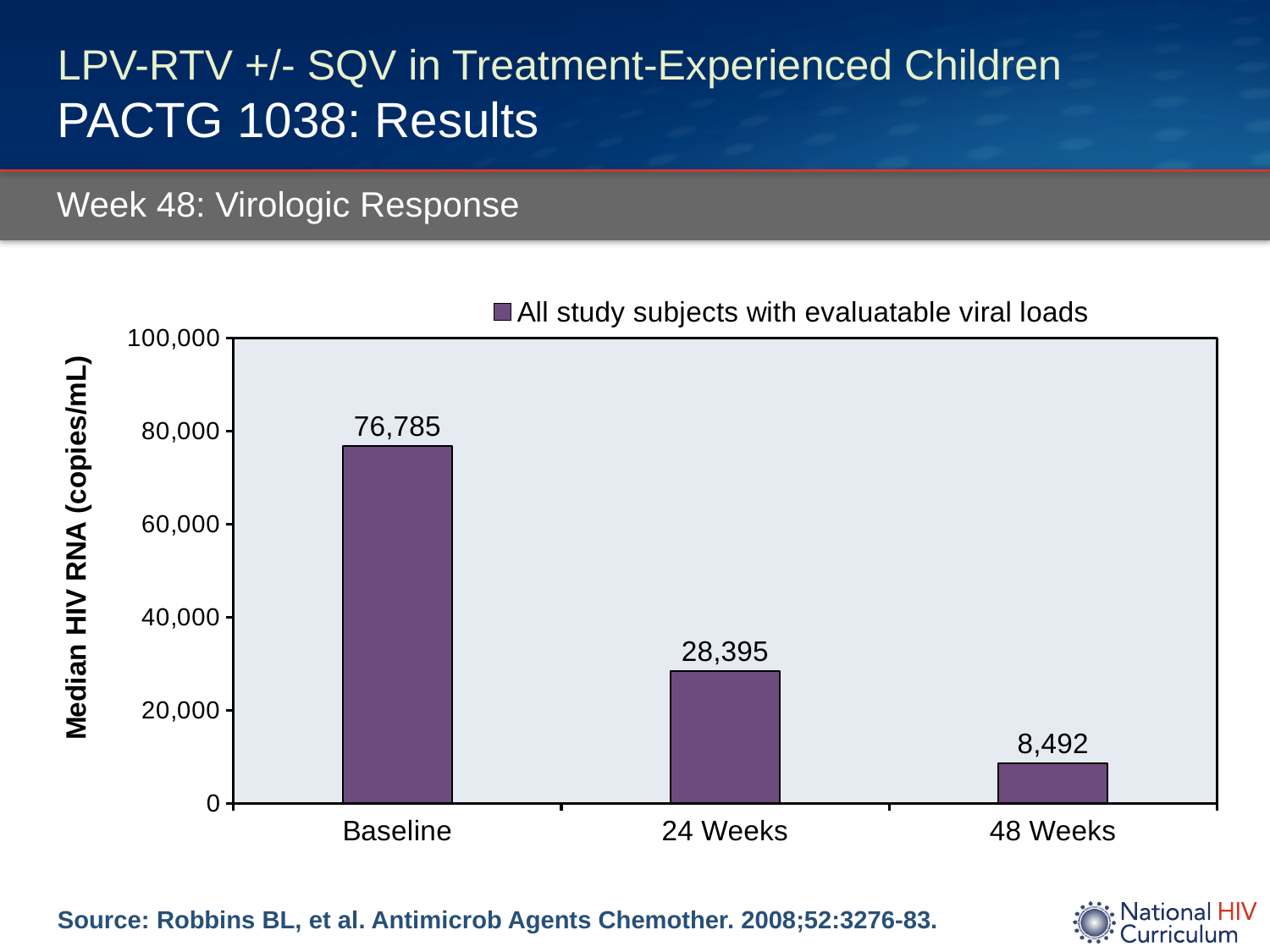
Which time point has the highest median HIV RNA? Baseline Which time point has the lowest median HIV RNA? 48 Weeks What is the median HIV RNA at Baseline? 76,785 How many time points are shown on the x axis? 3 What kind of chart is shown on the slide? Bar chart Do the median HIV RNA values rise or fall from Baseline to 48 Weeks? Fall What is the median HIV RNA at 48 Weeks? 8,492 Which is larger, the median HIV RNA at 24 Weeks or at 48 Weeks? 24 Weeks What is the difference in median HIV RNA between Baseline and 24 Weeks? 48,390 Is the median HIV RNA at 24 Weeks greater or less than 40,000? less What is the median HIV RNA at 24 Weeks? 28,395 What is the difference in median HIV RNA between Baseline and 48 Weeks? 68,293